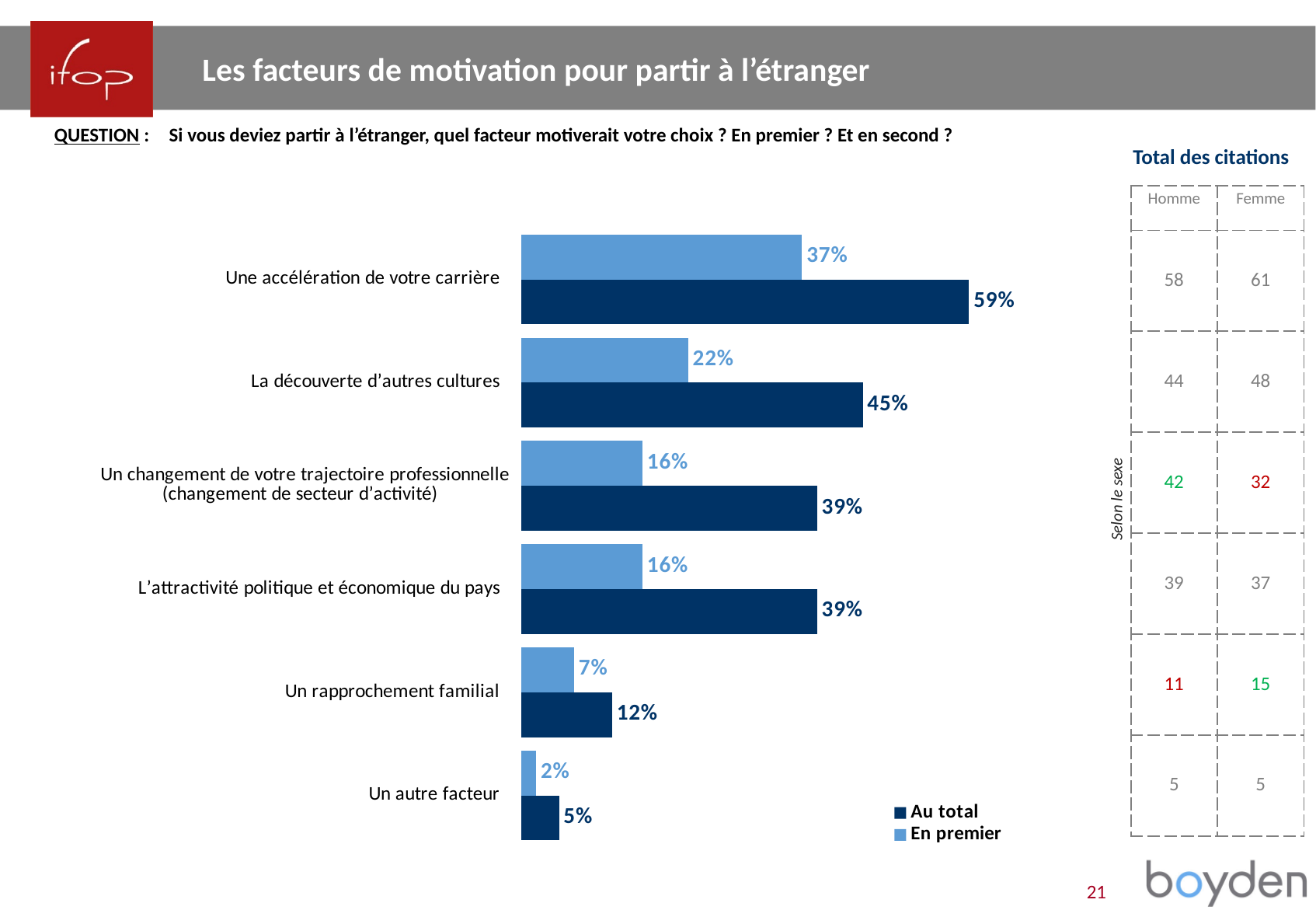
How many categories are shown in the bar chart? 6 Which series is shown in dark blue according to the legend? Au total Which category has the lowest 'En premier' value? Un autre facteur What is the difference between the 'Au total' and 'En premier' values for 'Une accélération de votre carrière'? 22% Which is larger: the 'Au total' value for 'La découverte d'autres cultures' or the 'Au total' value for 'L'attractivité politique et économique du pays'? La découverte d'autres cultures What is the 'Au total' value for 'Un rapprochement familial'? 12% What is the 'Au total' value for 'Une accélération de votre carrière'? 59% What kind of chart is shown on the slide? Bar chart Which category has the highest 'Au total' value? Une accélération de votre carrière What is the 'En premier' value for 'Un autre facteur'? 2% How many series does the legend list? 2 What is the 'En premier' value for 'La découverte d'autres cultures'? 22%